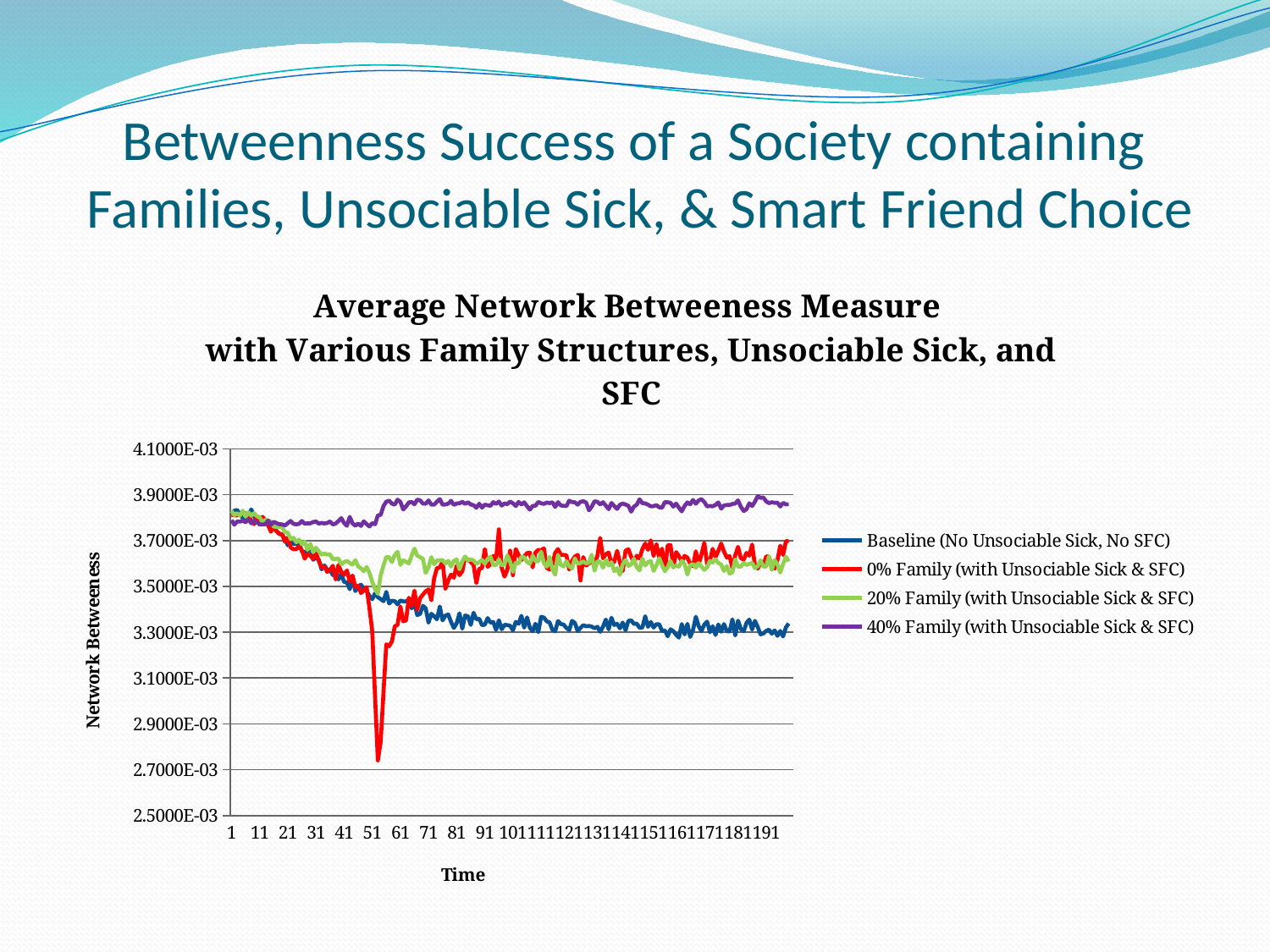
Which series has the lowest values at the end of the time axis (around time 191)? Baseline (No Unsociable Sick, No SFC) Is the lowest point of the 0% Family (with Unsociable Sick & SFC) series greater or less than 2.9000E-03? less How many series does the legend list? 4 At time 191, which series is higher: 20% Family (with Unsociable Sick & SFC) or Baseline (No Unsociable Sick, No SFC)? 20% Family (with Unsociable Sick & SFC) What is the label on the vertical axis of the chart? Network Betweeness Is the value of the Baseline (No Unsociable Sick, No SFC) series at time 191 greater or less than 3.5000E-03? less Does the Baseline (No Unsociable Sick, No SFC) series rise or fall over time? Fall What is the title of the chart? Average Network Betweeness Measure with Various Family Structures, Unsociable Sick, and SFC Is the value of the 40% Family (with Unsociable Sick & SFC) series at time 191 greater or less than 3.7000E-03? greater What kind of chart is shown on the slide? Line chart Which series drops to the lowest value anywhere on the chart? 0% Family (with Unsociable Sick & SFC) Which series has the highest values at the end of the time axis (around time 191)? 40% Family (with Unsociable Sick & SFC)